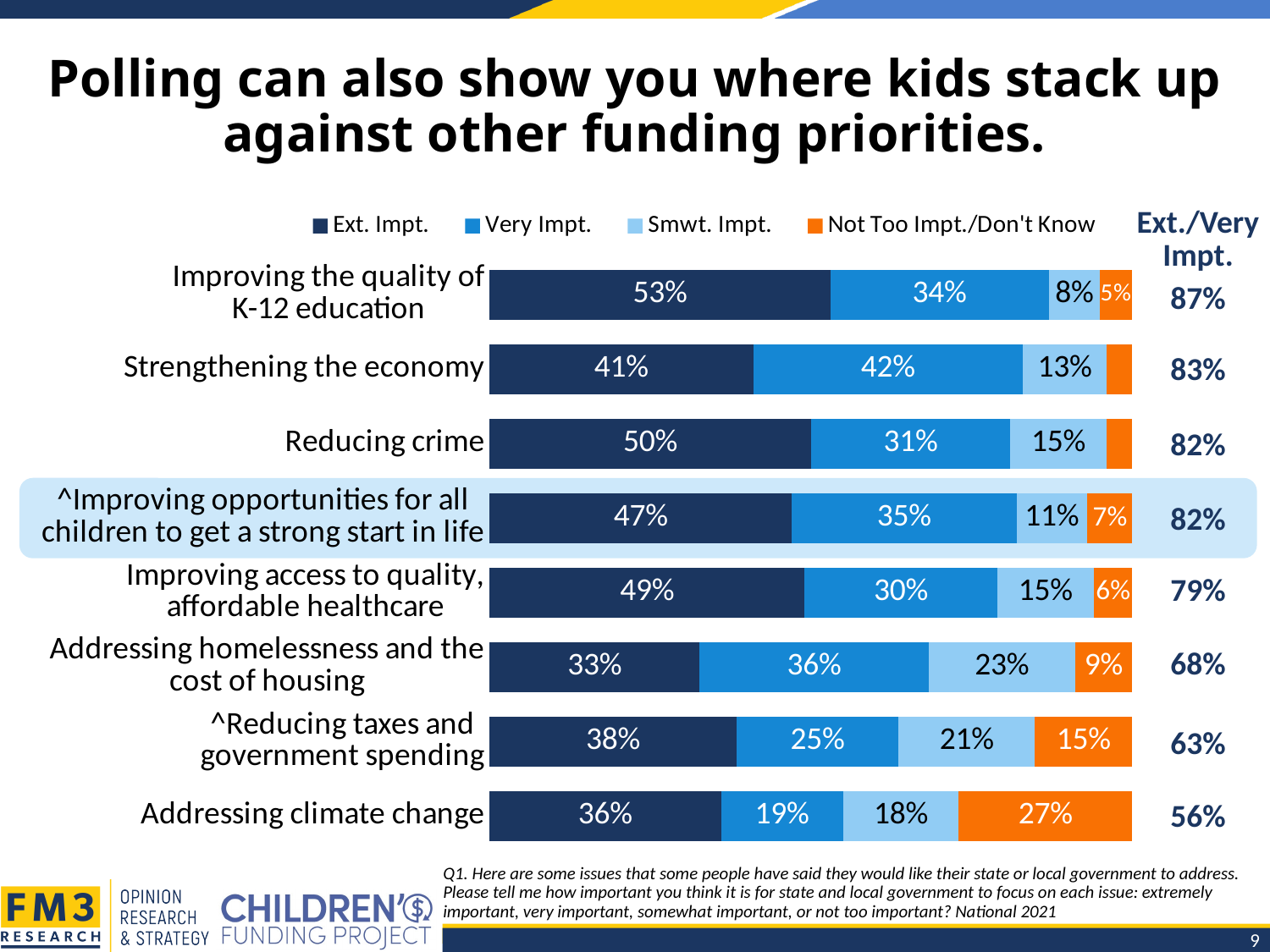
What percentage of respondents rated Improving the quality of K-12 education as Ext. Impt.? 53% What is the Not Too Impt./Don't Know value for Addressing climate change? 27% Which issue has the lowest Ext./Very Impt. combined percentage? Addressing climate change Which issue is highlighted with a shaded box on the slide? Improving opportunities for all children to get a strong start in life Which has a larger Smwt. Impt. value: Addressing homelessness and the cost of housing or Reducing taxes and government spending? Addressing homelessness and the cost of housing What is the combined Ext./Very Impt. percentage for Improving access to quality, affordable healthcare? 79% How many series does the legend list? 4 How many issues are shown in the chart? 8 For Addressing climate change, how many percentage points higher is the Ext. Impt. value than the Very Impt. value? 17 percentage points What kind of chart is shown on the slide? Stacked bar chart Which issue has the highest Ext. Impt. percentage? Improving the quality of K-12 education What is the Very Impt. value for Strengthening the economy? 42%